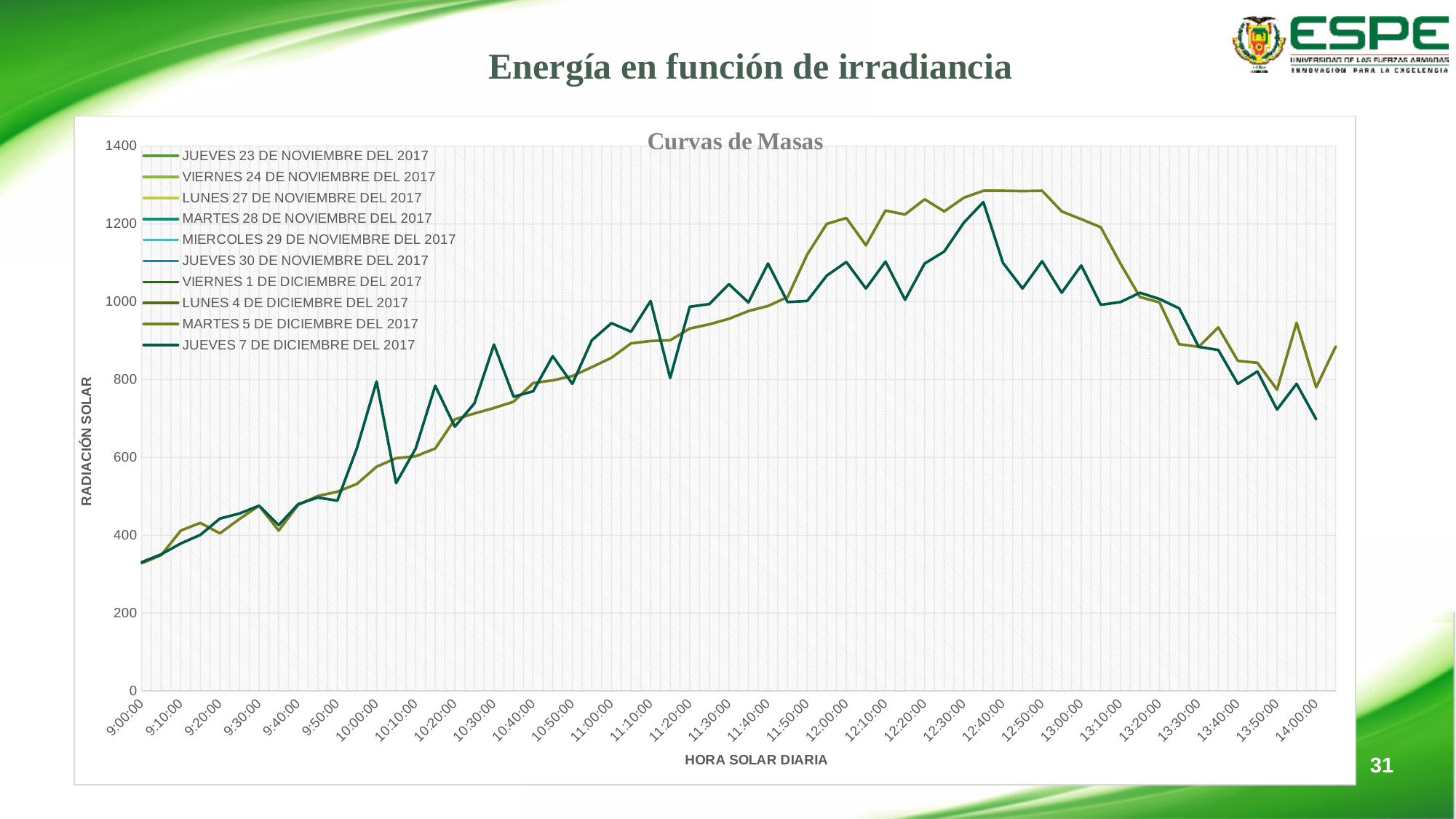
At 10:00:00, which plotted line has the higher value, the olive line or the dark green line? the dark green line What kind of chart is shown on the slide? line chart How many time labels are shown along the x axis of the chart? 31 How many series does the legend of the chart list? 10 Is the value of the olive line (MARTES 5 DE DICIEMBRE DEL 2017) at 9:00:00 greater or less than 400? less Is the value of the dark green line (JUEVES 7 DE DICIEMBRE DEL 2017) at 14:00:00 greater or less than 800? less What is the title of the chart? Curvas de Masas Does the olive line (MARTES 5 DE DICIEMBRE DEL 2017) generally rise or fall between 9:00:00 and 12:00:00? rise What is the label of the vertical axis of the chart? RADIACIÓN SOLAR Is the value of the olive line (MARTES 5 DE DICIEMBRE DEL 2017) at 12:50:00 greater or less than 1200? greater At 12:00:00, which plotted line has the higher value, the olive line or the dark green line? the olive line